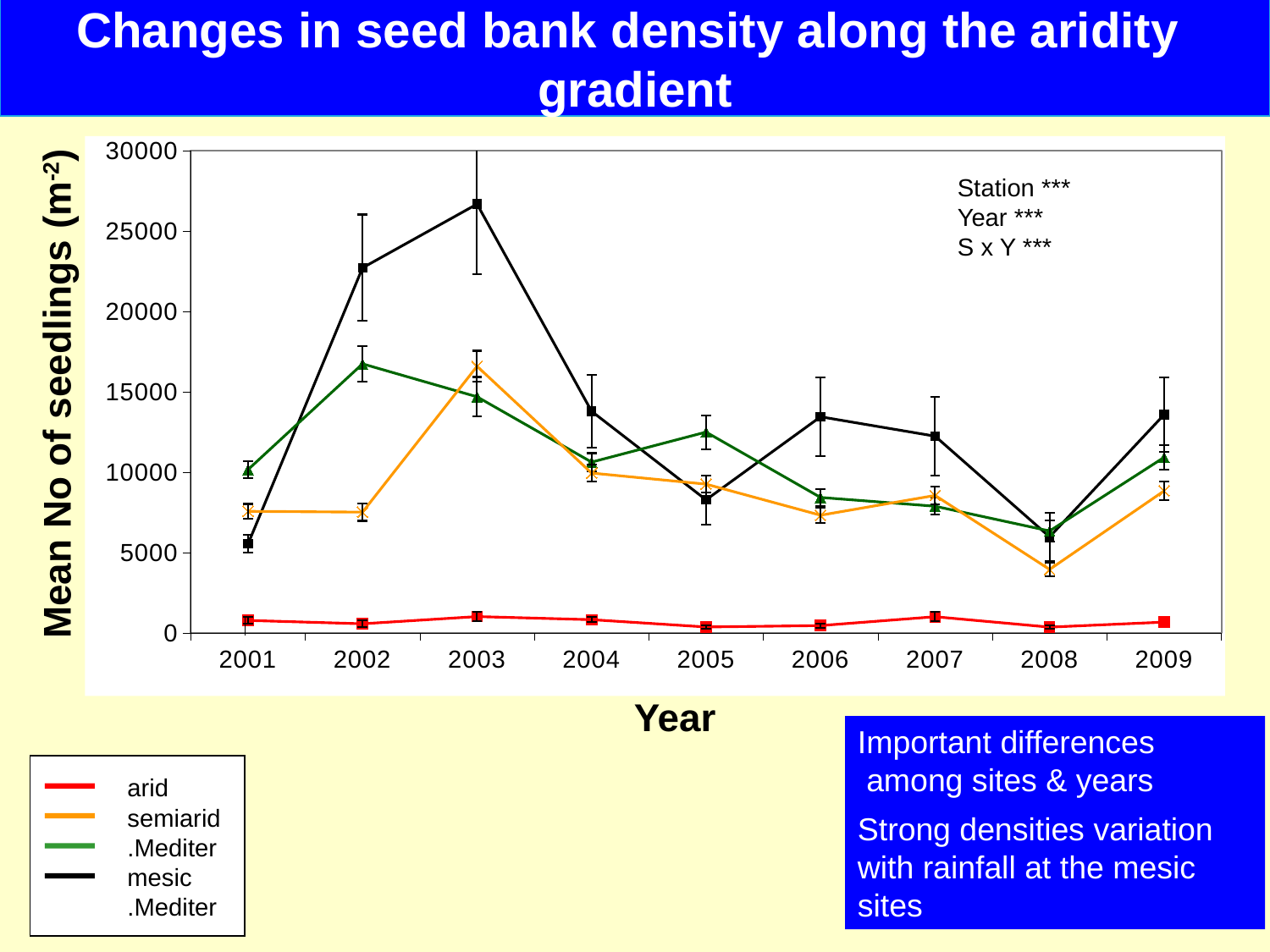
How many years are plotted along the x axis? 9 How many series does the legend list? 4 Is the semiarid value in 2008 greater or less than 5000? less In 2005, which is larger: the .Mediter value or the mesic .Mediter value? .Mediter In 2002, which is larger: the mesic .Mediter value or the .Mediter value? mesic .Mediter Is the mesic .Mediter value in 2003 greater or less than 25000? greater In which year does the mesic .Mediter series reach its highest value? 2003 Is the mesic .Mediter value in 2001 greater or less than 10000? less Does the mesic .Mediter series rise or fall from 2003 to 2005? fall In which year is the semiarid series at its lowest? 2008 Which series has the lowest values across all years? arid What kind of chart is shown on the slide? line chart